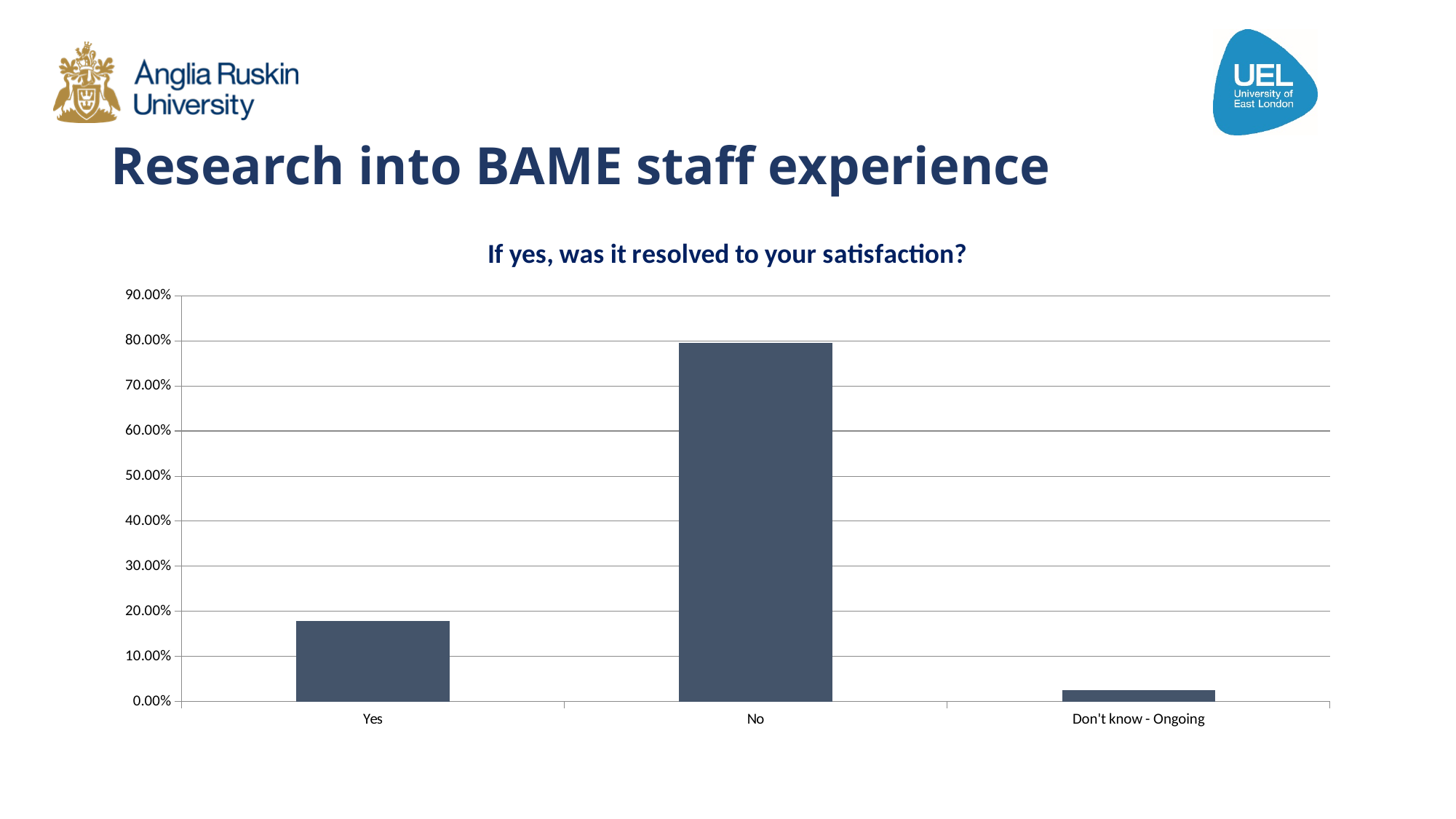
What is the highest value shown on the y axis of the chart? 90.00% What is the title of the chart? If yes, was it resolved to your satisfaction? How many categories are shown on the x axis of the chart? 3 Which category has the lowest value? Don't know - Ongoing What kind of chart is shown on the slide? bar chart Which is larger, the value for Yes or the value for Don't know - Ongoing? Yes Which category has the highest value? No Is the value for Yes greater or less than 20.00%? less Is the value for No greater or less than 70.00%? greater Is the value for Don't know - Ongoing greater or less than 10.00%? less Which is larger, the value for Yes or the value for No? No